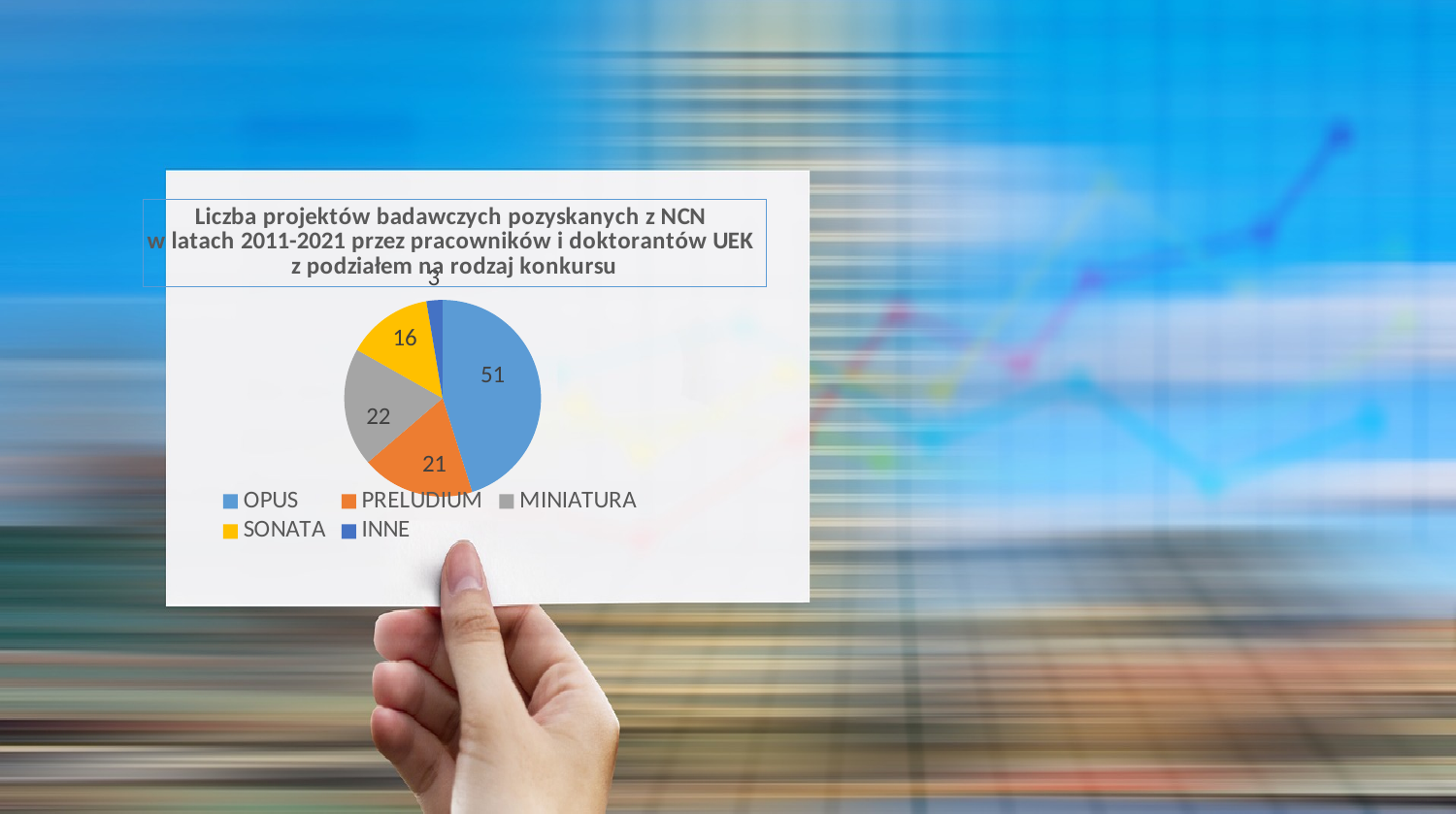
What is the value shown for MINIATURA? 22 Which is larger, the value for MINIATURA or the value for SONATA? MINIATURA What type of chart is shown on the slide? pie chart Which category has the smallest slice of the pie? INNE What is the difference between the OPUS value and the SONATA value? 35 What is the value shown for INNE? 3 How many categories does the legend list? 5 Which category has the largest slice of the pie? OPUS What is the value shown for PRELUDIUM? 21 What is the value shown for SONATA? 16 What colour is the OPUS slice in the pie chart? blue How many projects does the OPUS slice represent? 51